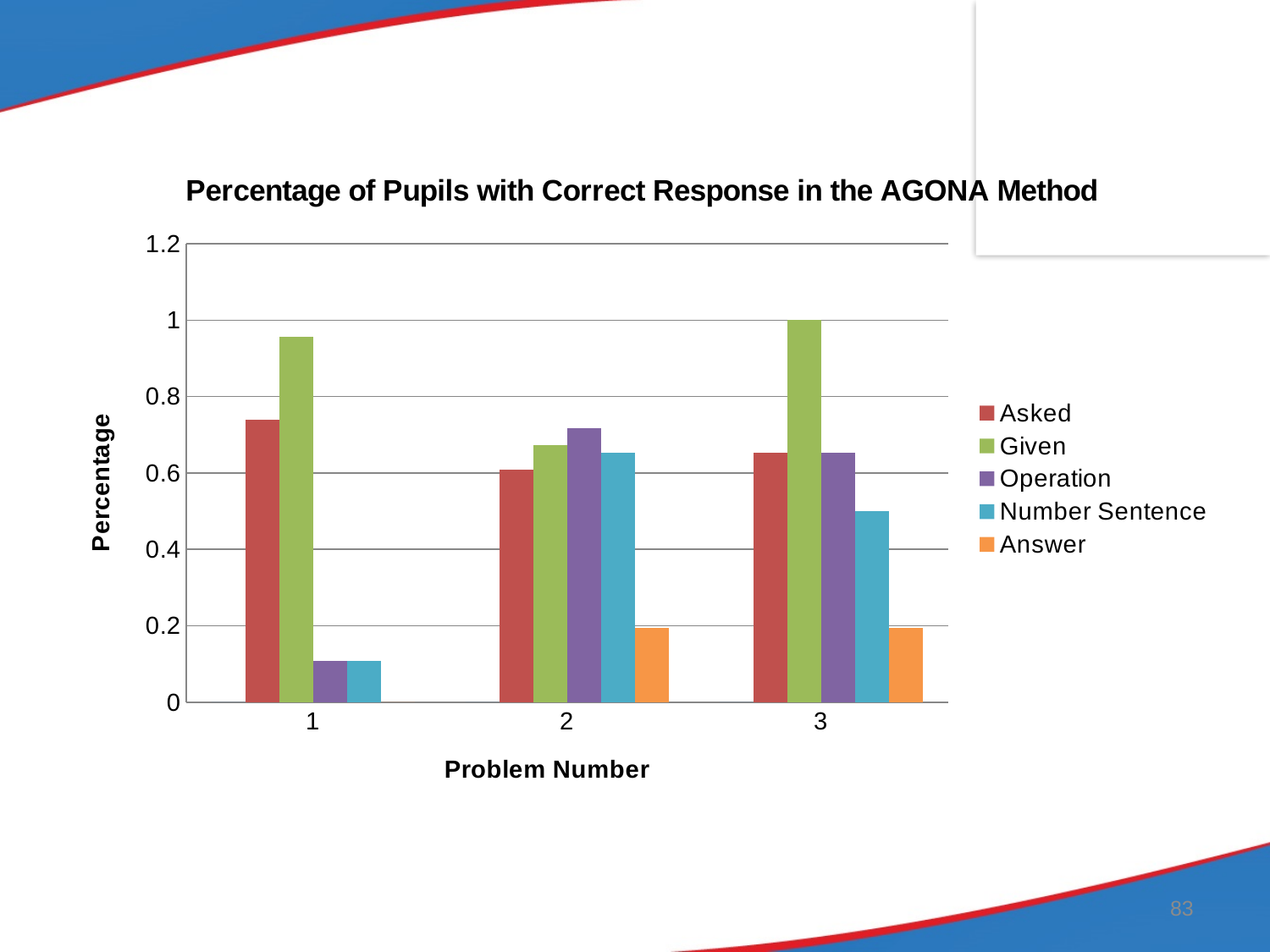
How many problem numbers are shown on the x axis? 3 Which series has the lowest value at problem number 3? Answer Is the value for Operation at problem number 1 greater or less than 0.2? less What is the title of the chart? Percentage of Pupils with Correct Response in the AGONA Method For which problem number is the Asked value highest? 1 What is the value for Given at problem number 3? 1 Which series has the highest value at problem number 2? Operation Is the value for Number Sentence at problem number 3 greater or less than 0.6? less At problem number 1, which is larger, Asked or Given? Given How many series does the legend list? 5 What kind of chart is shown on the slide? bar chart For which problem number is the Given value highest? 3